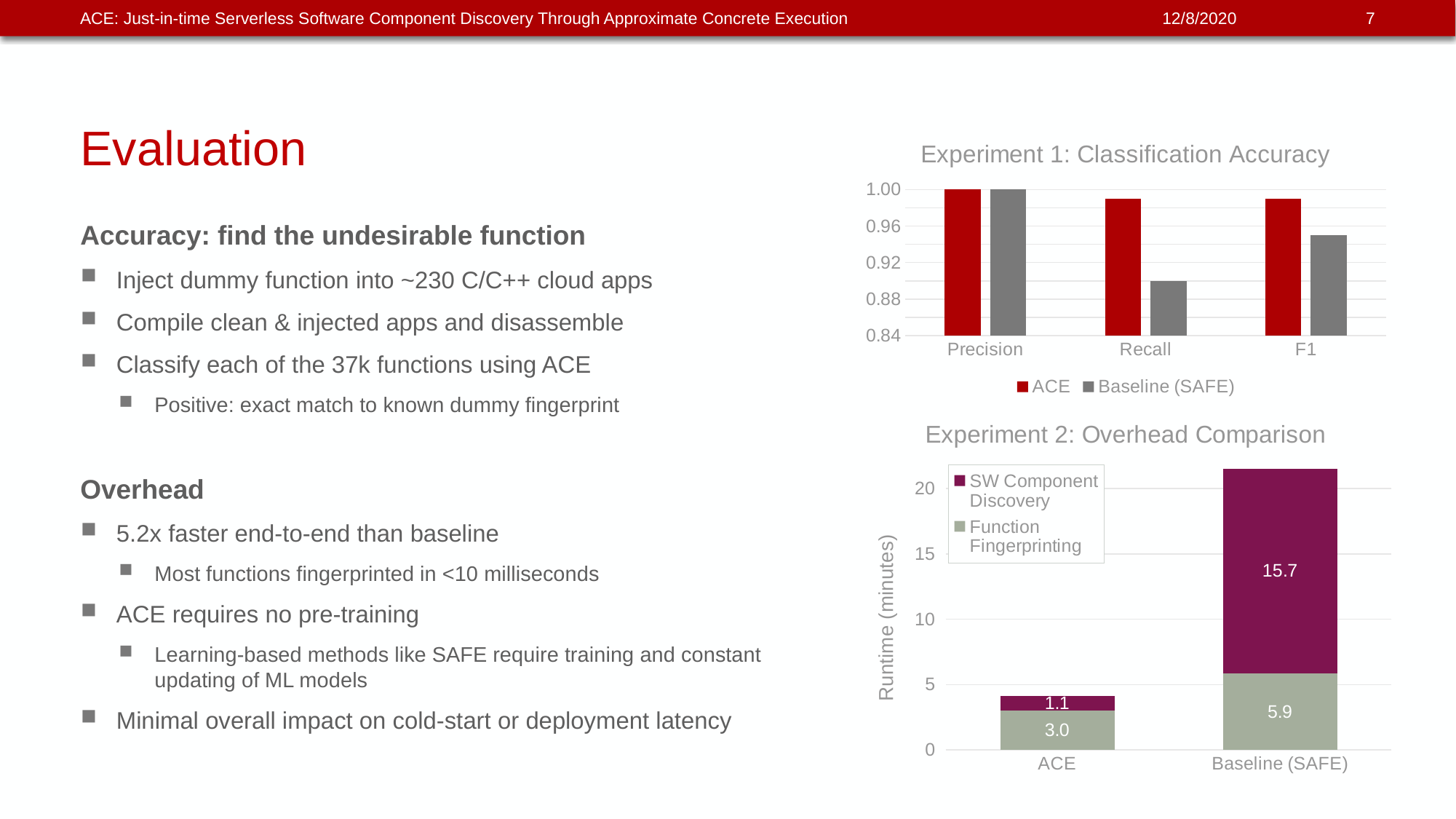
In the Experiment 2: Overhead Comparison chart, what is the difference between the Function Fingerprinting values for Baseline (SAFE) and ACE? 2.9 In the Experiment 1: Classification Accuracy chart, how many series does the legend list? 2 In the Experiment 1: Classification Accuracy chart, is the ACE value for F1 greater or less than 0.96? greater In the Experiment 1: Classification Accuracy chart, is the Baseline (SAFE) value for Recall greater or less than 0.92? less In the Experiment 1: Classification Accuracy chart, what is the ACE value for Precision? 1.00 In the Experiment 2: Overhead Comparison chart, what kind of chart is shown? Stacked bar chart In the Experiment 2: Overhead Comparison chart, what is the SW Component Discovery value for Baseline (SAFE)? 15.7 In the Experiment 1: Classification Accuracy chart, which series has the larger value for Recall, ACE or Baseline (SAFE)? ACE In the Experiment 2: Overhead Comparison chart, what is the label of the y axis? Runtime (minutes) In the Experiment 1: Classification Accuracy chart, how many categories are shown on the x axis? 3 In the Experiment 2: Overhead Comparison chart, what is the total runtime of the Baseline (SAFE) bar? 21.6 In the Experiment 2: Overhead Comparison chart, what is the Function Fingerprinting value for ACE? 3.0